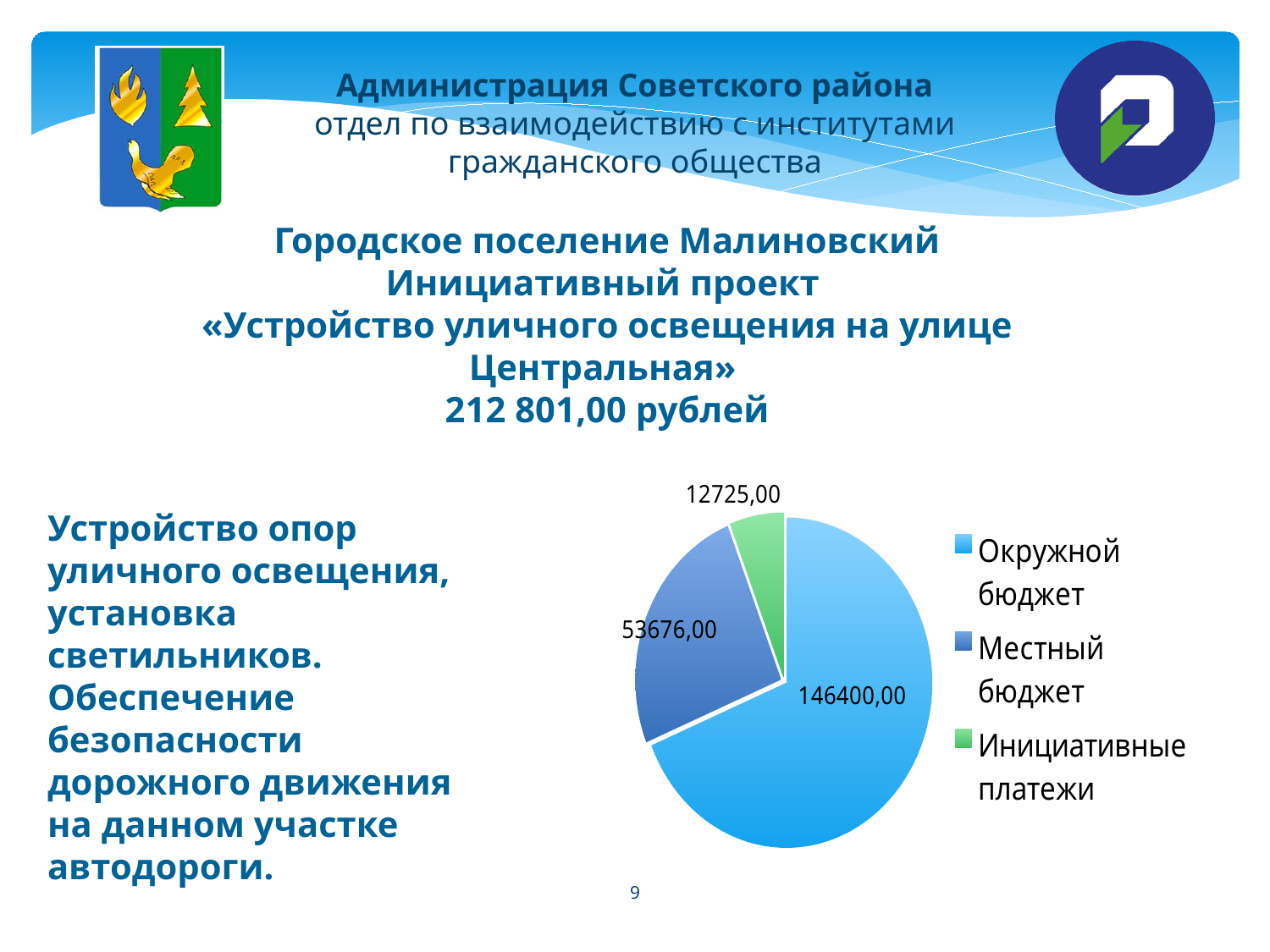
How many entries does the legend of the pie chart list? 3 What is the value for Окружной бюджет in the pie chart? 146400,00 How many slices does the pie chart have? 3 What is the difference between the values for Окружной бюджет and Местный бюджет? 92724,00 What is the difference between the values for Местный бюджет and Инициативные платежи? 40951,00 What kind of chart is shown on the slide? pie chart Which is larger: the value for Местный бюджет or the value for Инициативные платежи? Местный бюджет What is the value for Местный бюджет in the pie chart? 53676,00 Which category has the largest slice in the pie chart? Окружной бюджет What colour is the slice for Инициативные платежи in the pie chart? green What is the value for Инициативные платежи in the pie chart? 12725,00 Which category has the smallest slice in the pie chart? Инициативные платежи